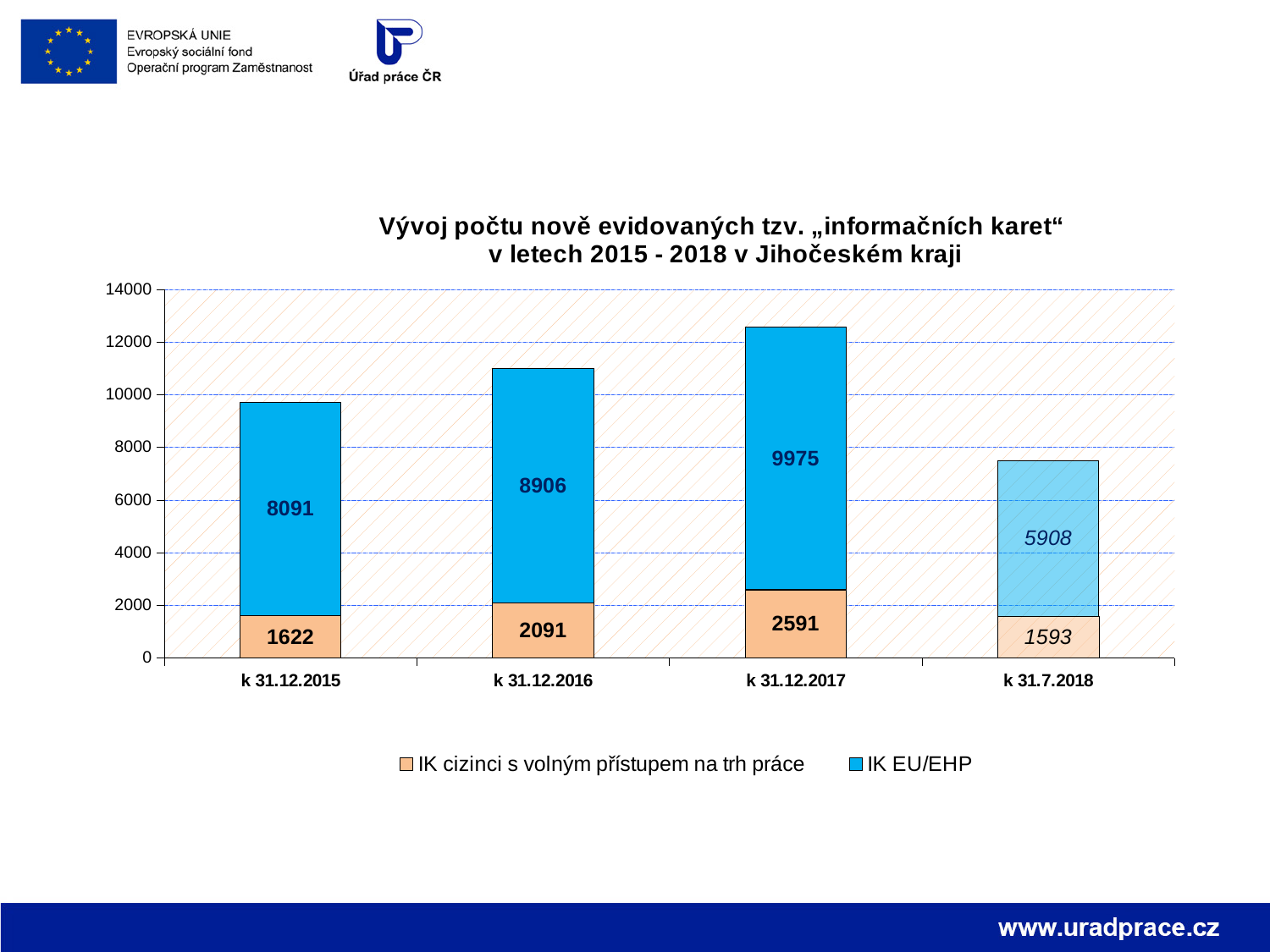
What is the value of IK cizinci s volným přístupem na trh práce for k 31.12.2017? 2591 Which category has the highest value for IK EU/EHP? k 31.12.2017 What is the total of the stacked bar for k 31.7.2018? 7501 What kind of chart is shown on the slide? stacked bar chart What is the total of the stacked bar for k 31.12.2016? 10997 What is the value of IK EU/EHP for k 31.12.2016? 8906 What is the value of IK EU/EHP for k 31.7.2018? 5908 How many series does the legend list? 2 Which is larger: IK cizinci s volným přístupem na trh práce for k 31.12.2015 or for k 31.12.2016? k 31.12.2016 What is the difference between the IK EU/EHP values for k 31.12.2017 and k 31.12.2015? 1884 How many categories are shown on the x axis? 4 Which category has the lowest value for IK cizinci s volným přístupem na trh práce? k 31.7.2018